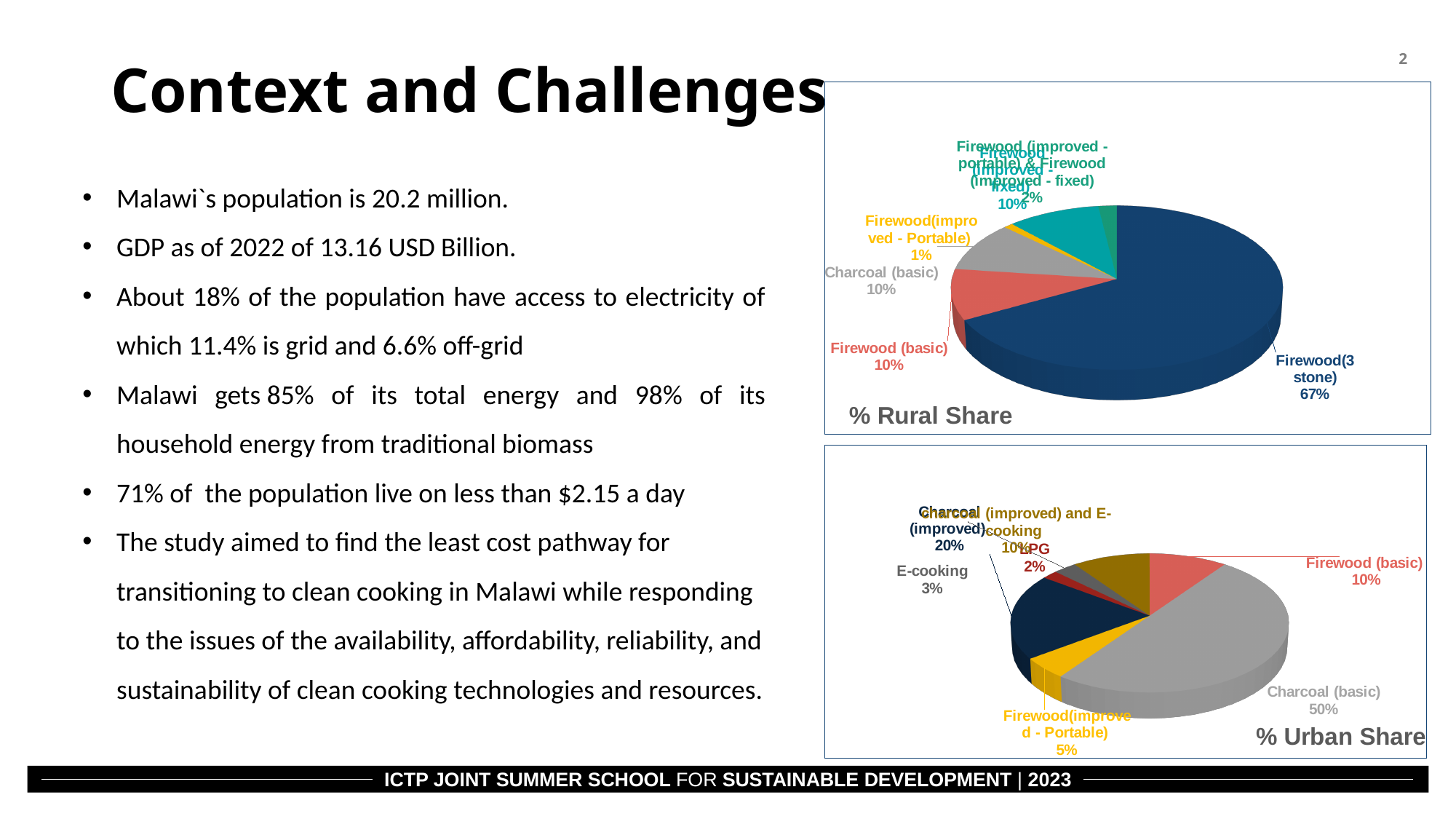
In the '% Urban Share' chart, what is the share for Firewood(improved - Portable)? 5% In the '% Rural Share' chart, what is the difference between the shares of Firewood(3 stone) and Charcoal (basic)? 57 percentage points What is the title of the lower pie chart on the slide? % Urban Share In the '% Rural Share' chart, which category has the largest share? Firewood(3 stone) In the '% Urban Share' chart, what is the share for E-cooking? 3% In the '% Urban Share' chart, which category has the largest share? Charcoal (basic) In the '% Rural Share' chart, what is the share for Firewood (basic)? 10% In the '% Urban Share' chart, what is the share for Charcoal (basic)? 50% In the '% Rural Share' chart, which category has the smallest share? Firewood(improved - Portable) In the '% Rural Share' chart, what is the share for Firewood(3 stone)? 67% In the '% Urban Share' chart, which is larger: the share for Charcoal (improved) or the share for Firewood (basic)? Charcoal (improved) What kind of chart is the '% Rural Share' chart? pie chart